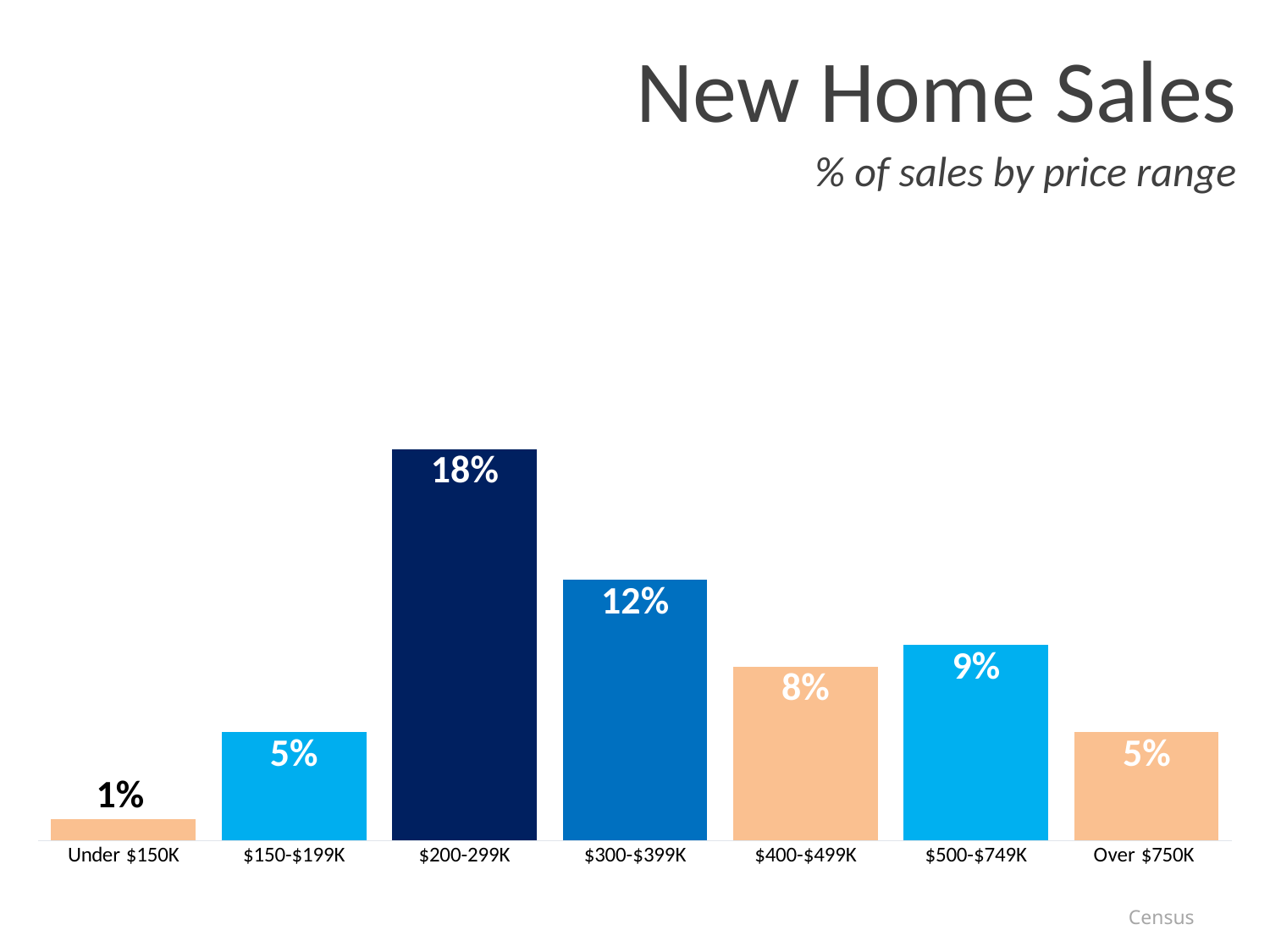
What is the source cited for the chart data? Census Which price range has the lowest share of new home sales? Under $150K What percentage of new home sales were in the $400-$499K price range? 8% Which has a larger share of sales, $400-$499K or $500-$749K? $500-$749K What type of chart is shown on the slide? Bar chart What percentage of new home sales were Over $750K? 5% What is the difference in percentage points between the $200-299K and $300-$399K price ranges? 6 What is the title of the chart? New Home Sales Which price range has the highest share of new home sales? $200-299K What percentage of new home sales were in the $200-299K price range? 18% How many price range categories are shown in the chart? 7 What is the combined share of sales for the Under $150K and $150-$199K price ranges? 6%